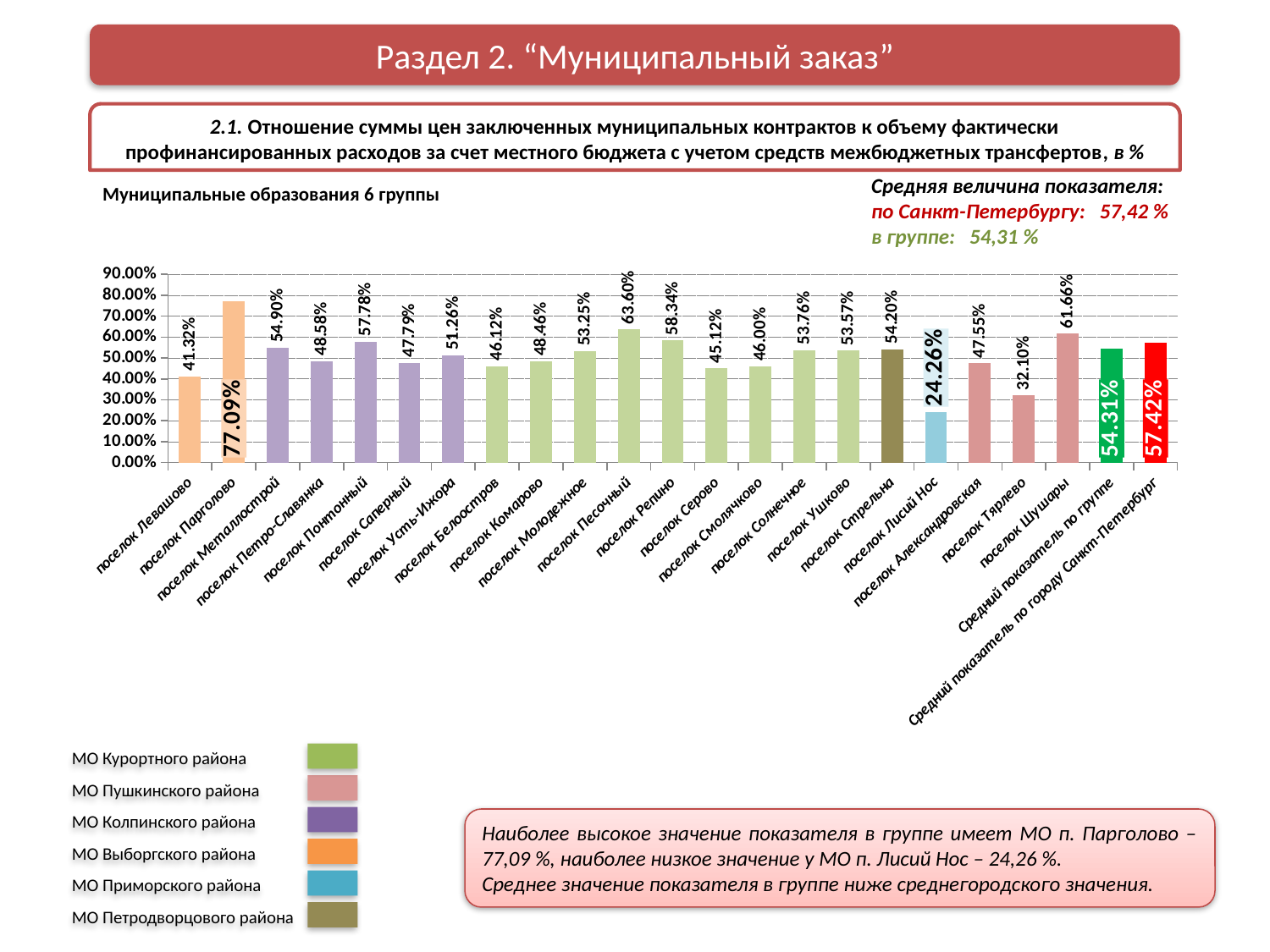
What kind of chart is shown on the slide? bar chart How many districts are listed in the colour legend below the chart? 6 What is the value for поселок Песочный? 63.60% How many bars are plotted on the chart? 23 What is the value shown for Средний показатель по группе? 54.31% What is the difference between the values for поселок Парголово and поселок Лисий Нос? 52.83% Is the value for поселок Левашово greater or less than 50.00%? less Which category has the lowest value on the chart? поселок Лисий Нос Which is larger, the value for поселок Шушары or the value for поселок Тярлево? поселок Шушары What is the value for поселок Парголово? 77.09% Which category has the highest value on the chart? поселок Парголово What is the value for поселок Лисий Нос? 24.26%